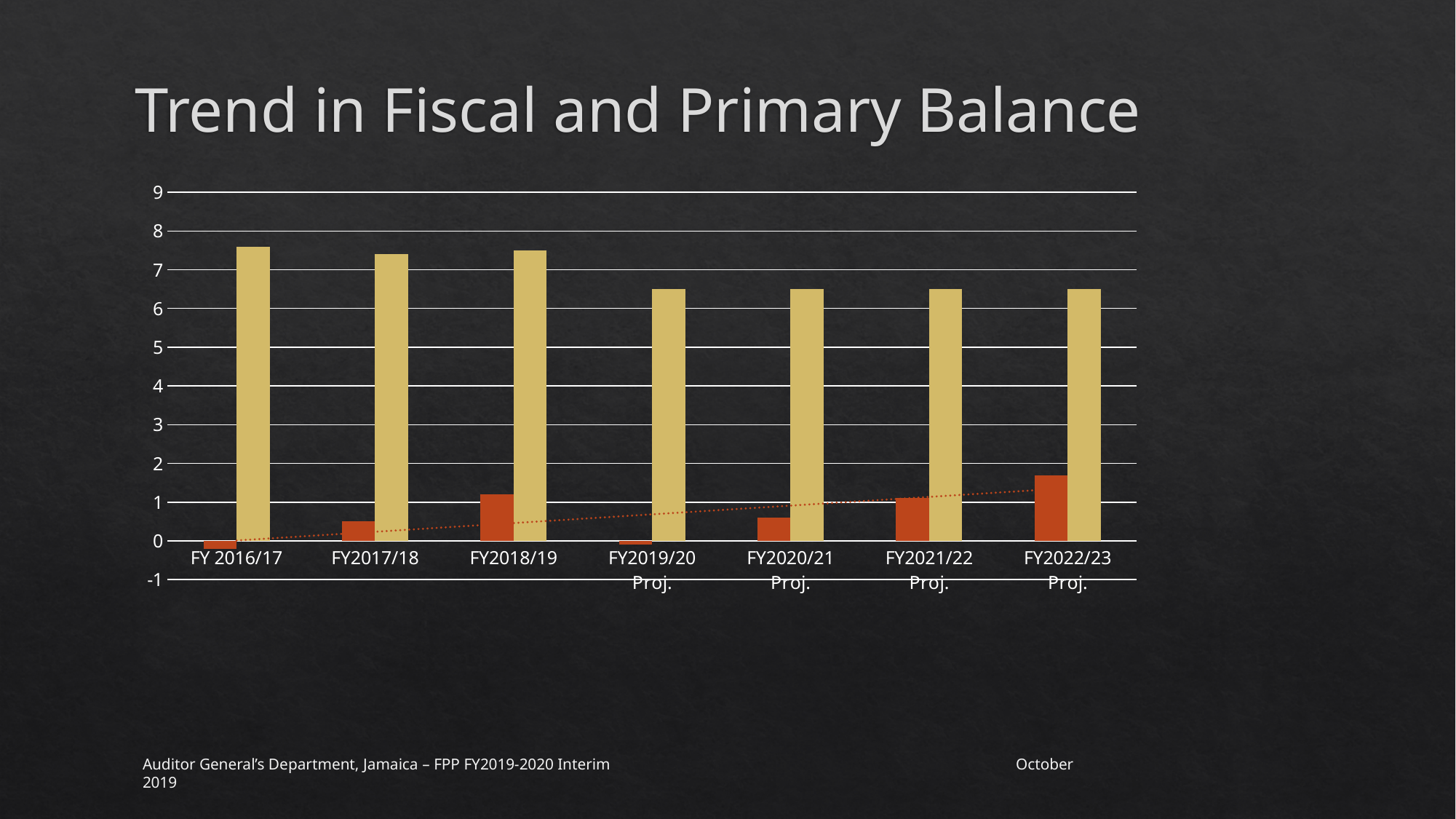
Which is larger, the orange bar for FY2018/19 or the orange bar for FY2020/21 Proj.? FY2018/19 Is the orange bar for FY2018/19 greater or less than 1? greater What is the title of the chart? Trend in Fiscal and Primary Balance Is the yellow bar for FY2019/20 Proj. greater or less than 7? less Which is larger, the yellow bar for FY2017/18 or the yellow bar for FY2020/21 Proj.? FY2017/18 Is the orange bar for FY2022/23 Proj. greater or less than 2? less Do the orange bars rise or fall from FY2019/20 Proj. to FY2022/23 Proj.? rise How many fiscal-year categories are shown on the x axis? 7 Which fiscal year has the tallest orange bar? FY2022/23 Proj. What kind of chart is shown on the slide? bar chart